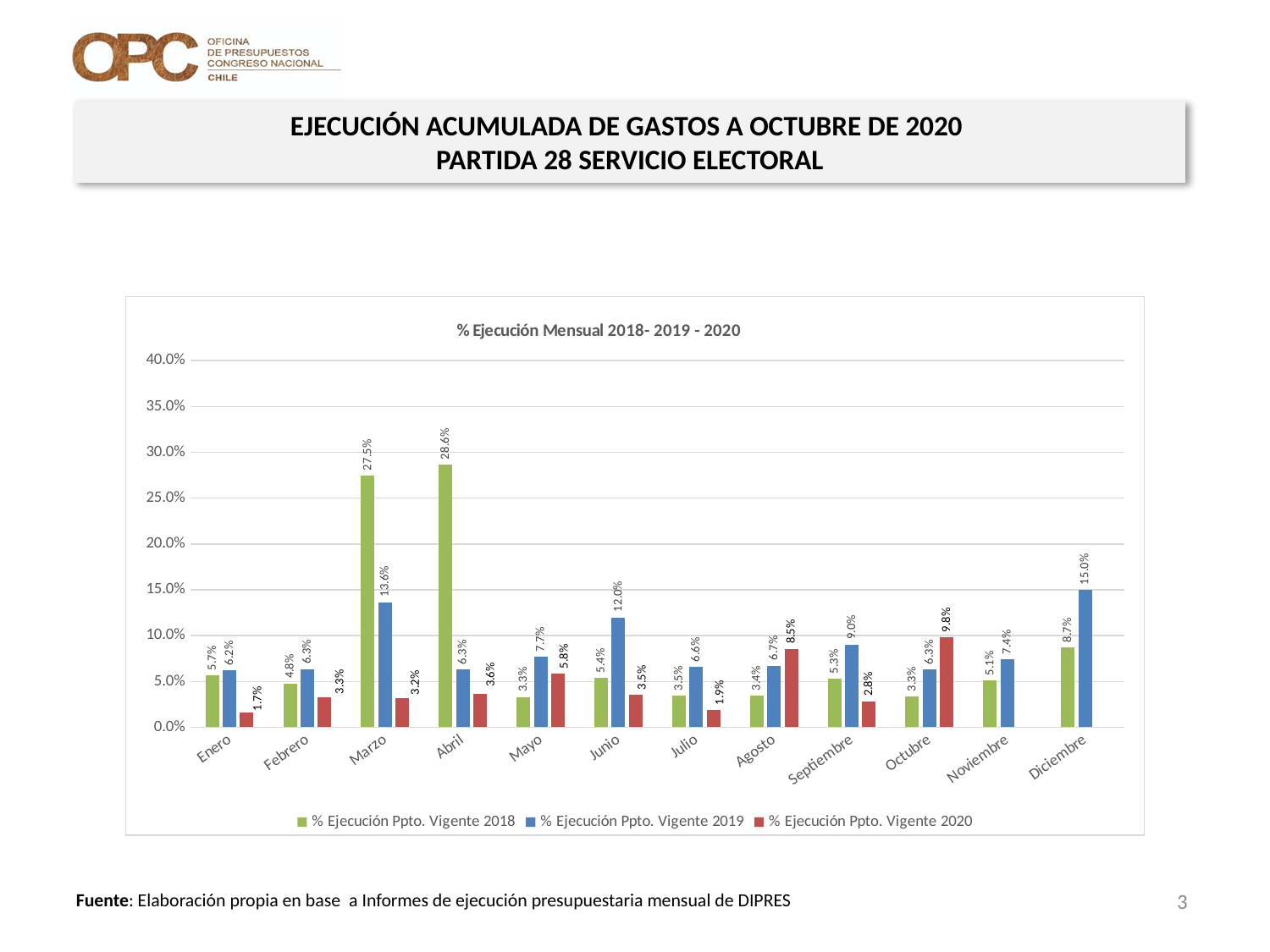
What is the value for % Ejecución Ppto. Vigente 2020 in Octubre? 9.8% Which month has the highest value for % Ejecución Ppto. Vigente 2018? Abril How many months are shown on the x axis? 12 How many series does the legend list? 3 What is the value for % Ejecución Ppto. Vigente 2019 in Junio? 12.0% What kind of chart is shown on the slide? Bar chart What is the value for % Ejecución Ppto. Vigente 2018 in Abril? 28.6% Which month has the lowest value for % Ejecución Ppto. Vigente 2020? Enero What is the difference between the 2018 and 2019 values in Marzo? 13.9% What is the title of the chart? % Ejecución Mensual 2018- 2019 - 2020 In Agosto, which series has the larger value: % Ejecución Ppto. Vigente 2019 or % Ejecución Ppto. Vigente 2020? % Ejecución Ppto. Vigente 2020 Is the value for % Ejecución Ppto. Vigente 2019 in Diciembre greater or less than 10.0%? greater